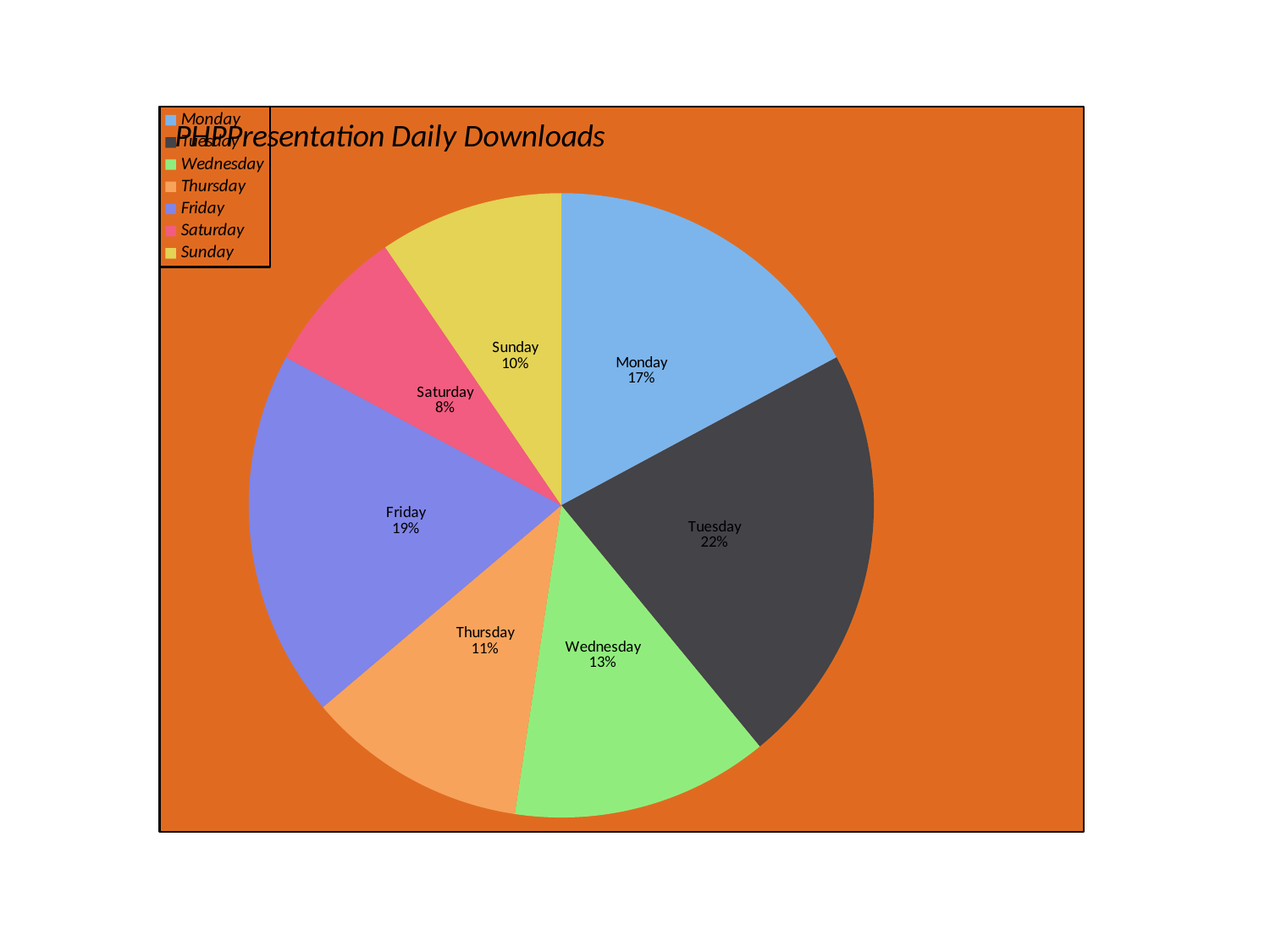
What is the title of the chart? PHPPresentation Daily Downloads Which is larger, the slice for Monday or the slice for Thursday? Monday Which day has the smallest slice of the pie? Saturday What share of the pie does Tuesday have? 22% Which day has the largest slice of the pie? Tuesday What is the difference in percentage points between Tuesday and Sunday? 12 What colour is the Friday slice? purple What share of the pie does Friday have? 19% How many slices does the pie chart have? 7 What kind of chart is shown on the slide? pie chart What percentage is shown for Wednesday? 13% What percentage is shown for Saturday? 8%